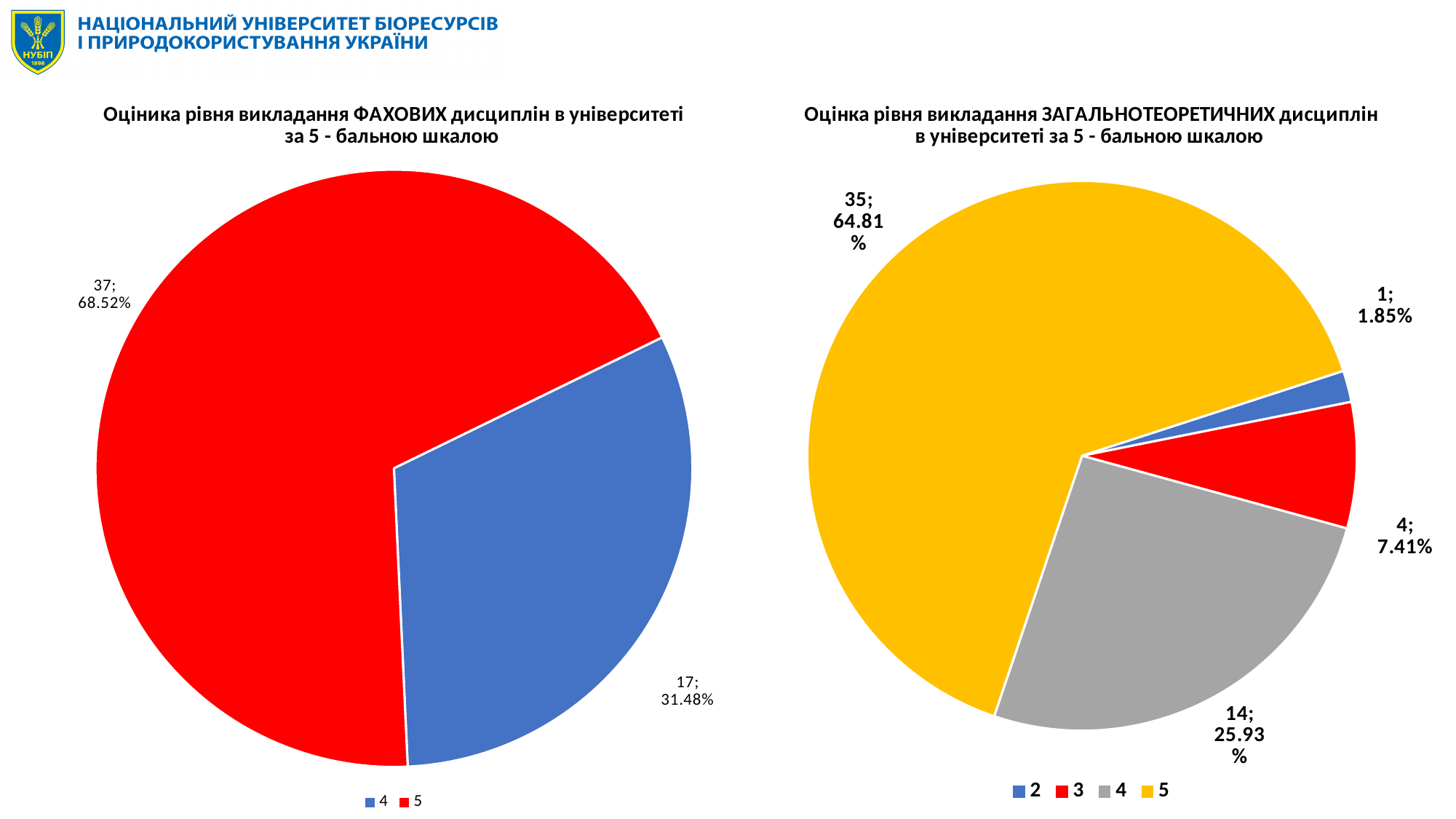
In the left pie chart (ФАХОВИХ дисциплін), how many responses gave a rating of 5? 37 What type of chart is used on the right side of the slide? pie chart In the right pie chart (ЗАГАЛЬНОТЕОРЕТИЧНИХ дисциплін), which rating has the smallest slice? 2 How many slices does the right pie chart (ЗАГАЛЬНОТЕОРЕТИЧНИХ дисциплін) have? 4 In the right pie chart (ЗАГАЛЬНОТЕОРЕТИЧНИХ дисциплін), what share of the pie does the rating 5 slice take? 64.81% In the right pie chart (ЗАГАЛЬНОТЕОРЕТИЧНИХ дисциплін), how many responses gave a rating of 4? 14 In the left pie chart (ФАХОВИХ дисциплін), what is the difference between the counts for rating 5 and rating 4? 20 In the left pie chart (ФАХОВИХ дисциплін), which rating has the largest slice? 5 How many entries does the legend of the left pie chart (ФАХОВИХ дисциплін) list? 2 In the right pie chart (ЗАГАЛЬНОТЕОРЕТИЧНИХ дисциплін), what colour is the slice for rating 5? yellow In the left pie chart (ФАХОВИХ дисциплін), what share of the pie does the rating 4 slice take? 31.48% In the right pie chart (ЗАГАЛЬНОТЕОРЕТИЧНИХ дисциплін), which is larger: the count for rating 3 or the count for rating 4? rating 4